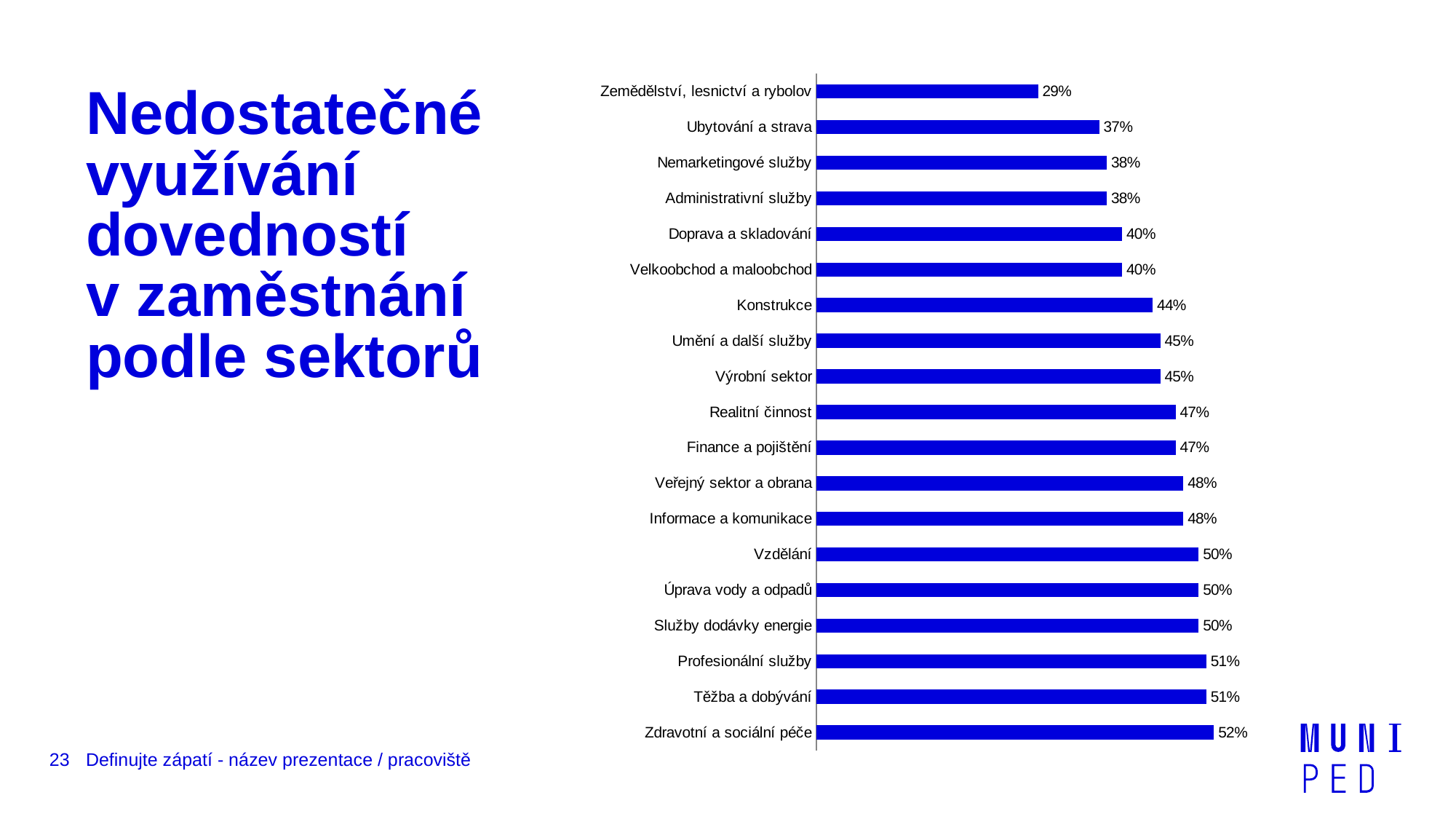
What is the value for Informace a komunikace? 48% Which is larger, the value for Doprava a skladování or the value for Realitní činnost? Realitní činnost Which sector has the highest value? Zdravotní a sociální péče What is the value for Vzdělání? 50% Which sector has the lowest value? Zemědělství, lesnictví a rybolov What is the title of the slide? Nedostatečné využívání dovedností v zaměstnání podle sektorů How many sectors are shown in the chart? 19 What is the difference between the values for Zdravotní a sociální péče and Zemědělství, lesnictví a rybolov? 23% What is the difference between the values for Konstrukce and Ubytování a strava? 7% What is the value for Konstrukce? 44% What is the value for Zemědělství, lesnictví a rybolov? 29% What kind of chart is shown on the slide? Bar chart